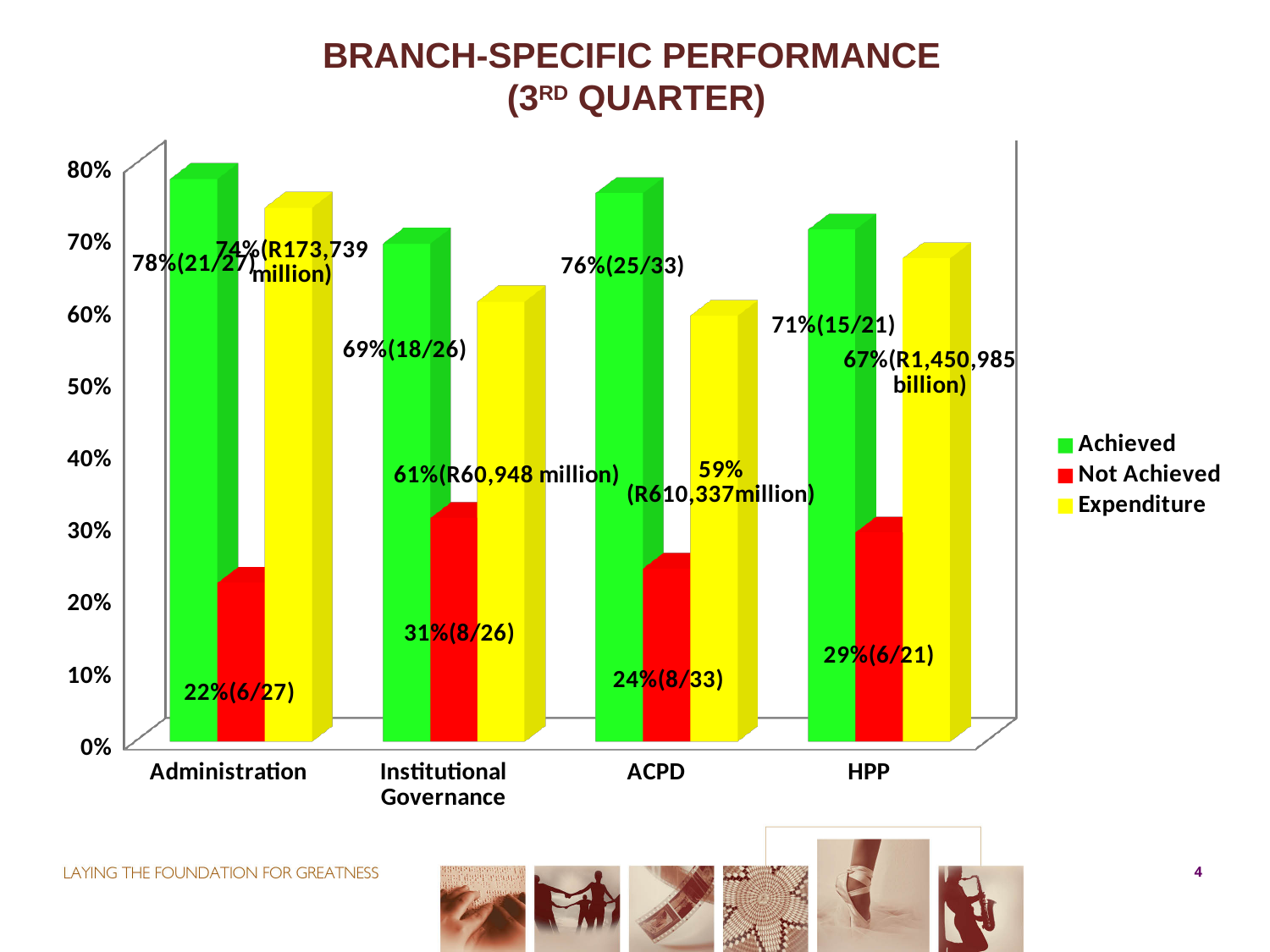
What is the title of the chart? BRANCH-SPECIFIC PERFORMANCE (3RD QUARTER) What is the Not Achieved value for Institutional Governance? 31% Which is larger, the Not Achieved value for HPP or the Not Achieved value for ACPD? HPP How many branches are shown on the x axis? 4 Which branch has the lowest Expenditure value? ACPD What is the difference between the Achieved values for Administration and Institutional Governance? 9% How many series does the legend list? 3 Which branch has the highest Achieved value? Administration What is the Achieved value for HPP? 71% What is the Expenditure value for ACPD? 59% What is the Achieved value for Administration? 78% What type of chart is shown on the slide? bar chart